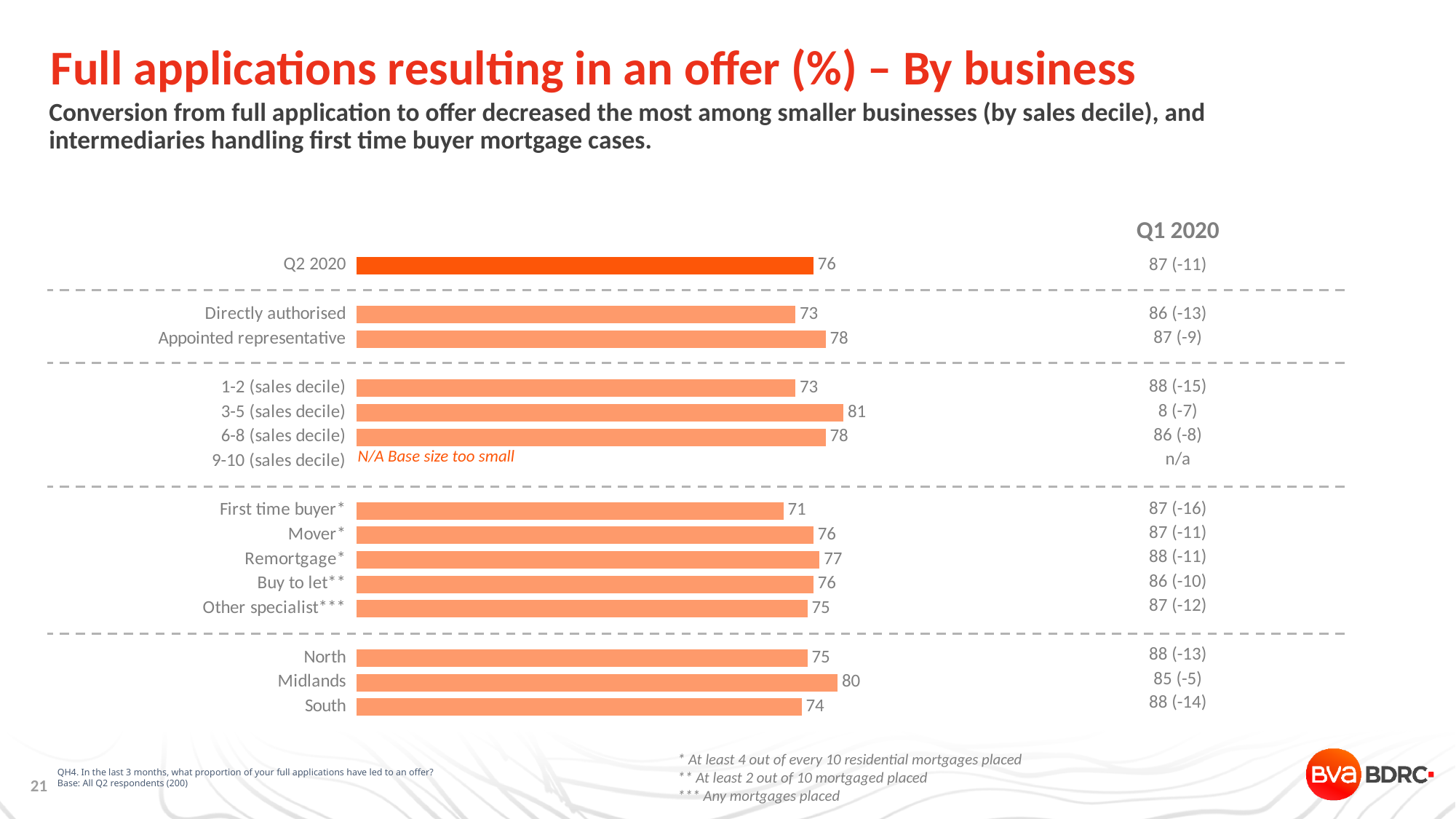
What is shown for 9-10 (sales decile) instead of a bar? N/A Base size too small What kind of chart is shown on the slide? Bar chart What is the value for First time buyer? 71 Which category has the highest value? 3-5 (sales decile) What is the value for Appointed representative? 78 What is the difference between the values for Midlands and South? 6 What is the difference between the values for Remortgage and First time buyer? 6 What is the value for Midlands? 80 Which category has the lowest value? First time buyer Which is larger, the value for Directly authorised or Appointed representative? Appointed representative What is the Q1 2020 figure shown for North? 88 (-13) How many regions (North, Midlands, South) are plotted in the bottom group? 3